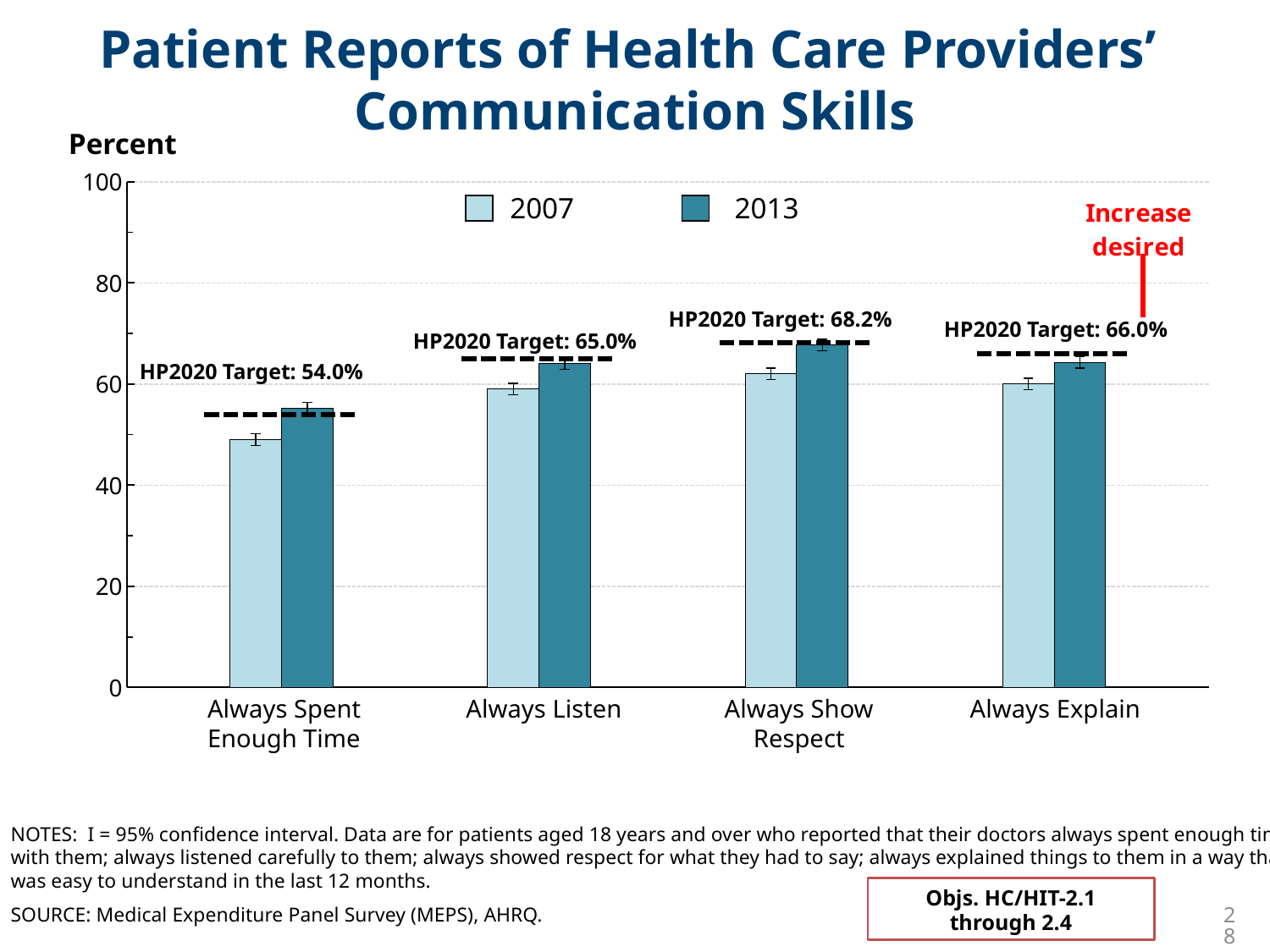
What is the HP2020 Target shown for Always Show Respect? 68.2% What kind of chart is shown on the slide? bar chart How many categories are shown on the x axis? 4 Is the 2007 value for Always Spent Enough Time greater or less than 60? less What are the two years listed in the legend? 2007 and 2013 Which category has the highest HP2020 Target? Always Show Respect Is the 2013 value for Always Show Respect greater or less than 60? greater How many series does the legend list? 2 For Always Spent Enough Time, which is larger, the 2007 value or the 2013 value? 2013 Which category has the lowest 2007 value? Always Spent Enough Time Which category has the highest 2013 value? Always Show Respect What is the HP2020 Target shown for Always Spent Enough Time? 54.0%